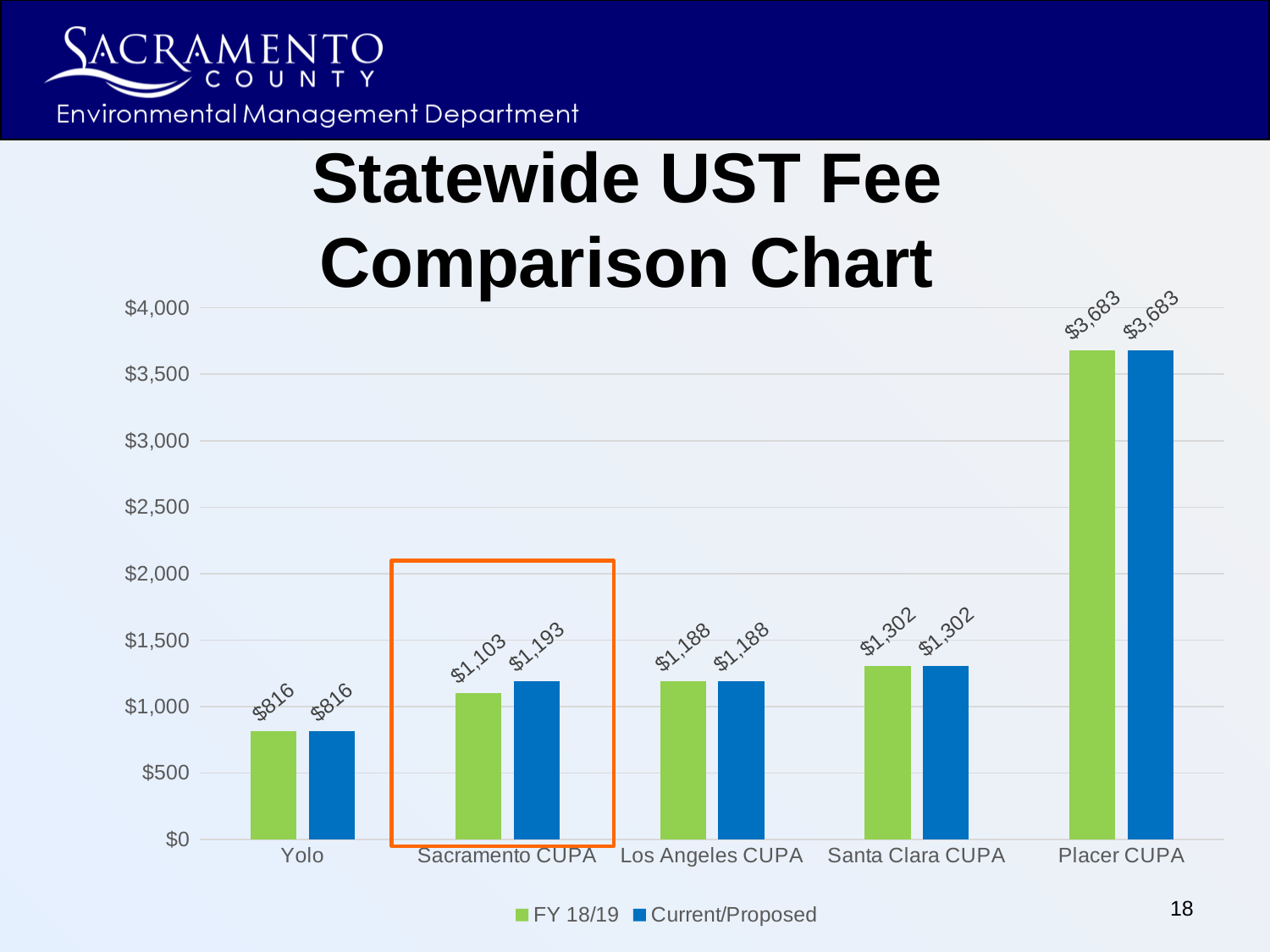
What kind of chart is shown on the slide? bar chart What is the FY 18/19 value for Yolo? $816 How many categories are shown on the x axis? 5 Which category has the lowest FY 18/19 value? Yolo Is the FY 18/19 value for Placer CUPA greater or less than $3,500? greater What is the Current/Proposed value for Santa Clara CUPA? $1,302 How many series does the legend list? 2 What is the Current/Proposed value for Sacramento CUPA? $1,193 Which is larger, the Current/Proposed value for Los Angeles CUPA or the Current/Proposed value for Santa Clara CUPA? Santa Clara CUPA What is the difference between the Current/Proposed and FY 18/19 values for Sacramento CUPA? $90 Which category has the highest Current/Proposed value? Placer CUPA What is the FY 18/19 value for Sacramento CUPA? $1,103